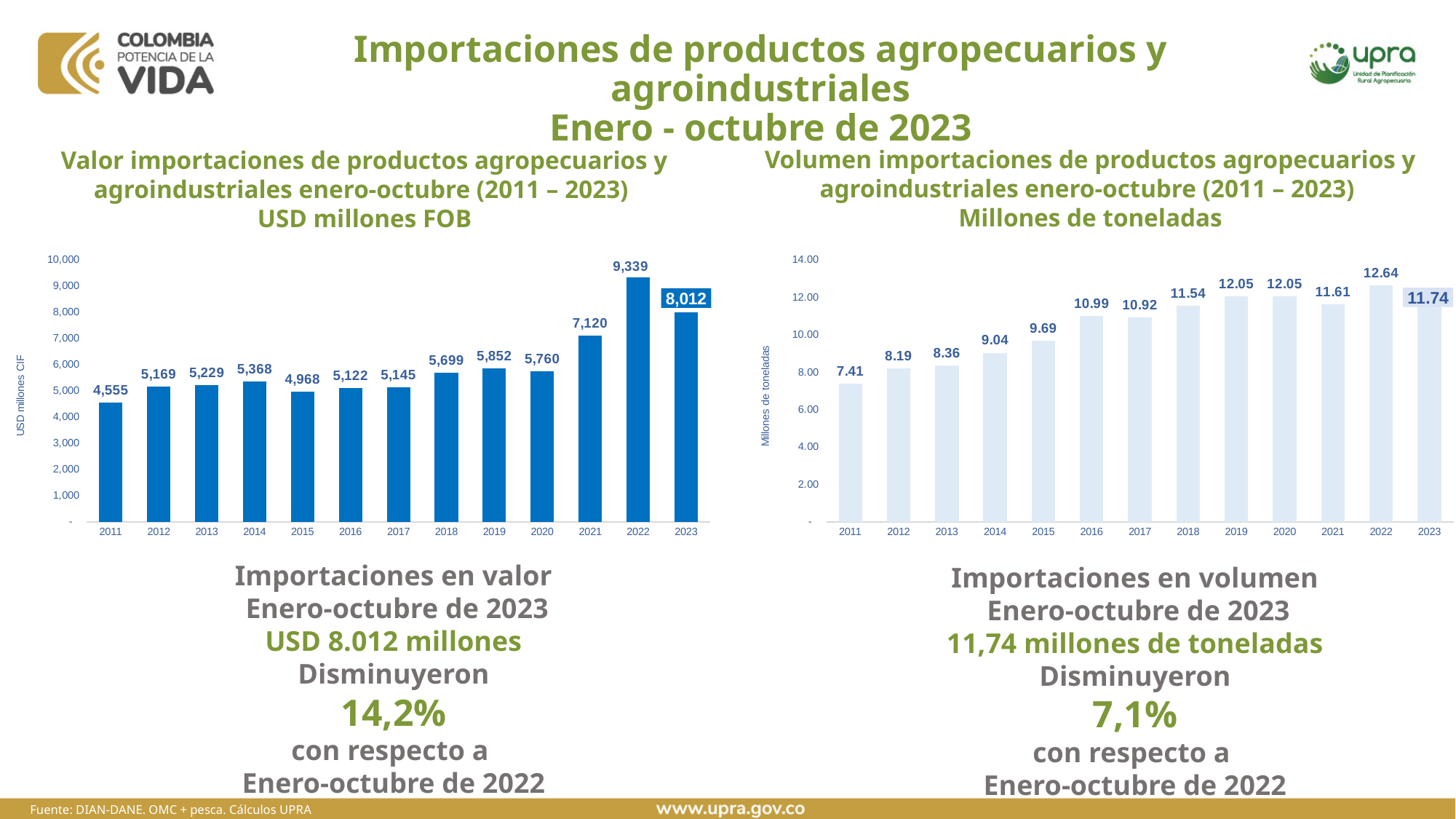
In the right chart (Volumen importaciones, Millones de toneladas), which is larger, the value for 2016 or the value for 2017? 2016 In the right chart (Volumen importaciones, Millones de toneladas), what is the value for 2011? 7.41 In the right chart (Volumen importaciones, Millones de toneladas), which year has the highest value? 2022 In the left chart (Valor importaciones, USD millones FOB), what is the difference between the 2022 and 2023 values? 1,327 In the right chart (Volumen importaciones, Millones de toneladas), do the values generally rise or fall from 2011 to 2022? Rise In the right chart (Volumen importaciones, Millones de toneladas), what is the difference between the 2022 and 2023 values? 0.90 In the left chart (Valor importaciones, USD millones FOB), how many years are plotted? 13 In the left chart (Valor importaciones, USD millones FOB), what is the label on the vertical axis? USD millones CIF In the right chart (Volumen importaciones, Millones de toneladas), what kind of chart is shown? Bar chart In the left chart (Valor importaciones, USD millones FOB), which year has the lowest value? 2011 In the left chart (Valor importaciones, USD millones FOB), what is the value for 2023? 8,012 In the left chart (Valor importaciones, USD millones FOB), which year has the highest value? 2022